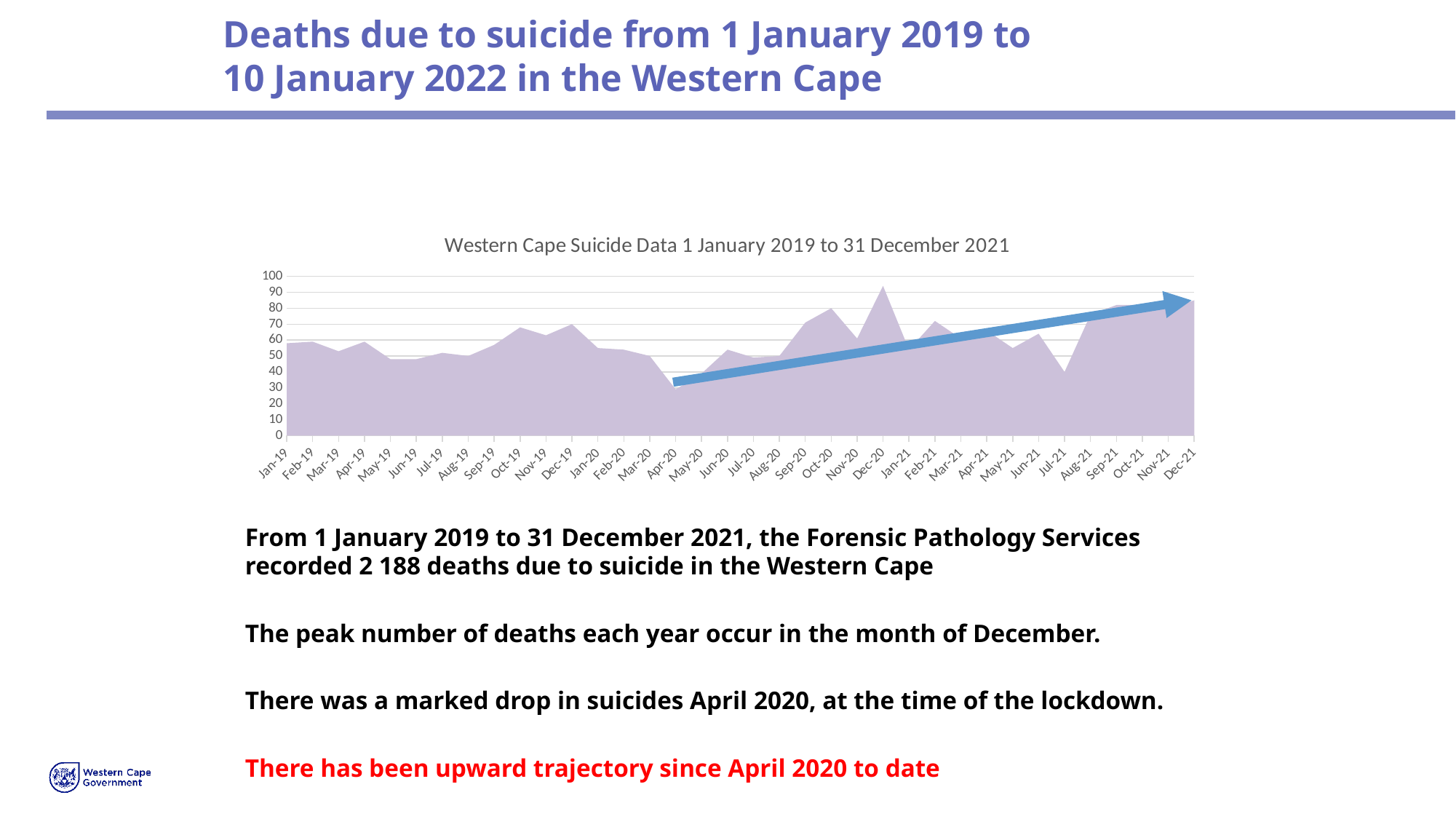
Is the value for Apr-20 greater or less than 40? less Which month has the lowest value in the chart? Apr-20 What is the title of the chart? Western Cape Suicide Data 1 January 2019 to 31 December 2021 What kind of chart is shown on the slide? Area chart How many monthly data points are plotted on the x axis of the chart? 36 Is the value for Dec-20 greater or less than 80? greater Do the values generally rise or fall from Apr-20 to Dec-21? rise Which is larger, the value for Oct-20 or the value for Jan-21? Oct-20 Is the value for Oct-19 greater or less than 60? greater Which month has the highest value in the chart? Dec-20 What is the maximum value shown on the chart's vertical axis? 100